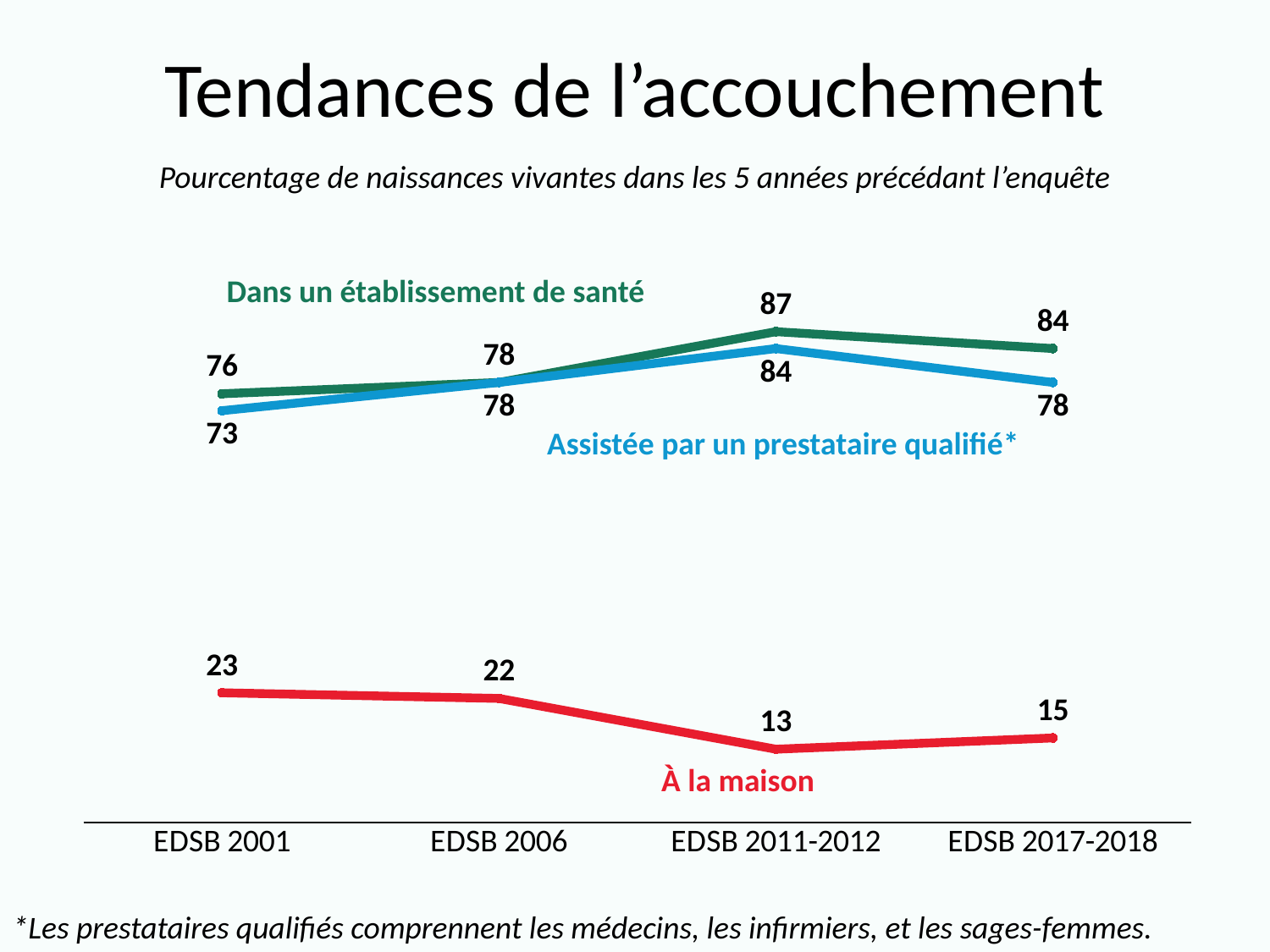
How many surveys are shown on the x axis? 4 Does the "À la maison" series rise or fall from EDSB 2001 to EDSB 2011-2012? Fall What is the value for "Assistée par un prestataire qualifié" at EDSB 2017-2018? 78 What kind of chart is shown on the slide? Line chart What is the difference between the "Dans un établissement de santé" and "Assistée par un prestataire qualifié" values at EDSB 2017-2018? 6 How many series are plotted on the chart? 3 What is the value for "À la maison" at EDSB 2001? 23 What is the value for "Dans un établissement de santé" at EDSB 2011-2012? 87 In which survey is the value for "À la maison" lowest? EDSB 2011-2012 By how much did the "À la maison" value change from EDSB 2001 to EDSB 2011-2012? 10 In which survey is the value for "Dans un établissement de santé" highest? EDSB 2011-2012 Which is larger at EDSB 2001: "Dans un établissement de santé" or "Assistée par un prestataire qualifié"? Dans un établissement de santé